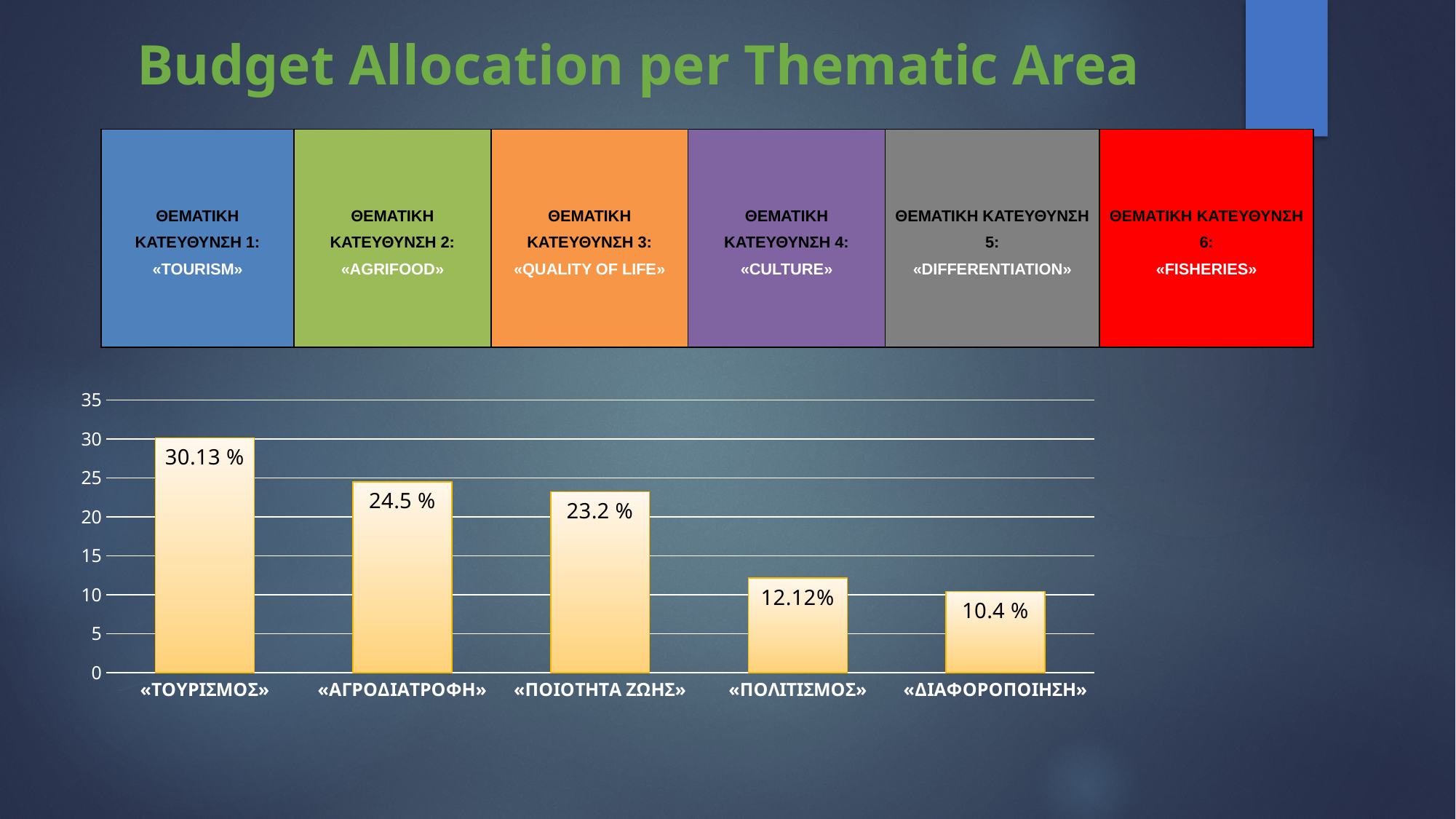
What is the value for «ΔΙΑΦΟΡΟΠΟΙΗΣΗ» in the chart? 10.4 % Which is larger, the value for «ΑΓΡΟΔΙΑΤΡΟΦΗ» or the value for «ΠΟΙΟΤΗΤΑ ΖΩΗΣ»? «ΑΓΡΟΔΙΑΤΡΟΦΗ» Which category has the lowest value in the chart? «ΔΙΑΦΟΡΟΠΟΙΗΣΗ» What is the difference between the values for «ΤΟΥΡΙΣΜΟΣ» and «ΑΓΡΟΔΙΑΤΡΟΦΗ»? 5.63 % How many categories are shown in the bar chart? 5 Do the values rise or fall from left to right across the categories? Fall What kind of chart is shown on the slide? Bar chart What is the value for «ΠΟΙΟΤΗΤΑ ΖΩΗΣ» in the chart? 23.2 % What is the value for «ΑΓΡΟΔΙΑΤΡΟΦΗ» in the chart? 24.5 % Which category has the highest value in the chart? «ΤΟΥΡΙΣΜΟΣ» What is the value for «ΤΟΥΡΙΣΜΟΣ» in the chart? 30.13 % What is the value for «ΠΟΛΙΤΙΣΜΟΣ» in the chart? 12.12%